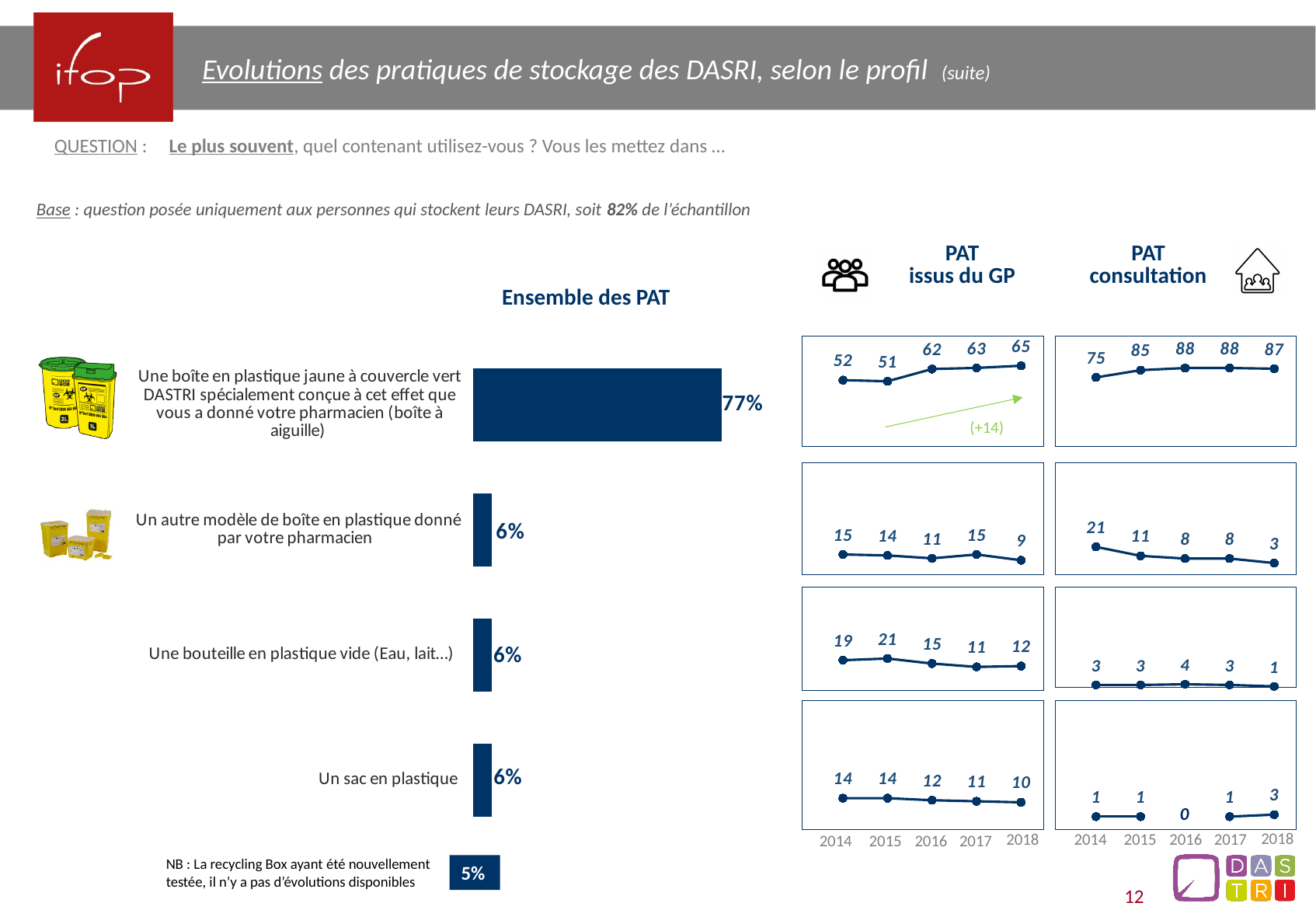
In the 'Ensemble des PAT' bar chart, what is the value for 'Un sac en plastique'? 6% In the 'Ensemble des PAT' bar chart, what is the difference between the value for the DASTRI boîte à aiguille and the value for 'Une bouteille en plastique vide'? 71% In the 'PAT consultation' line chart for the DASTRI boîte à aiguille, which year has the lowest value? 2014 What kind of chart is 'Ensemble des PAT'? Bar chart In the 'PAT consultation' line chart for 'Un autre modèle de boîte en plastique donné par votre pharmacien', what is the value in 2014? 21 In the 'PAT issus du GP' line chart for the DASTRI boîte à aiguille, what is the value in 2014? 52 In the 'PAT issus du GP' line chart for the DASTRI boîte à aiguille, what is the value in 2018? 65 In the 'Ensemble des PAT' bar chart, what is the value for 'Une boîte en plastique jaune à couvercle vert DASTRI...' (boîte à aiguille)? 77% In the 'PAT issus du GP' line chart for 'Une bouteille en plastique vide', do the values generally rise or fall from 2014 to 2018? Fall In the 'Ensemble des PAT' bar chart, which category has the highest value? Une boîte en plastique jaune à couvercle vert DASTRI (boîte à aiguille) In the 'PAT consultation' line chart for 'Un sac en plastique', what is the value in 2016? 0 How many years are plotted in each 'PAT issus du GP' line chart? 5